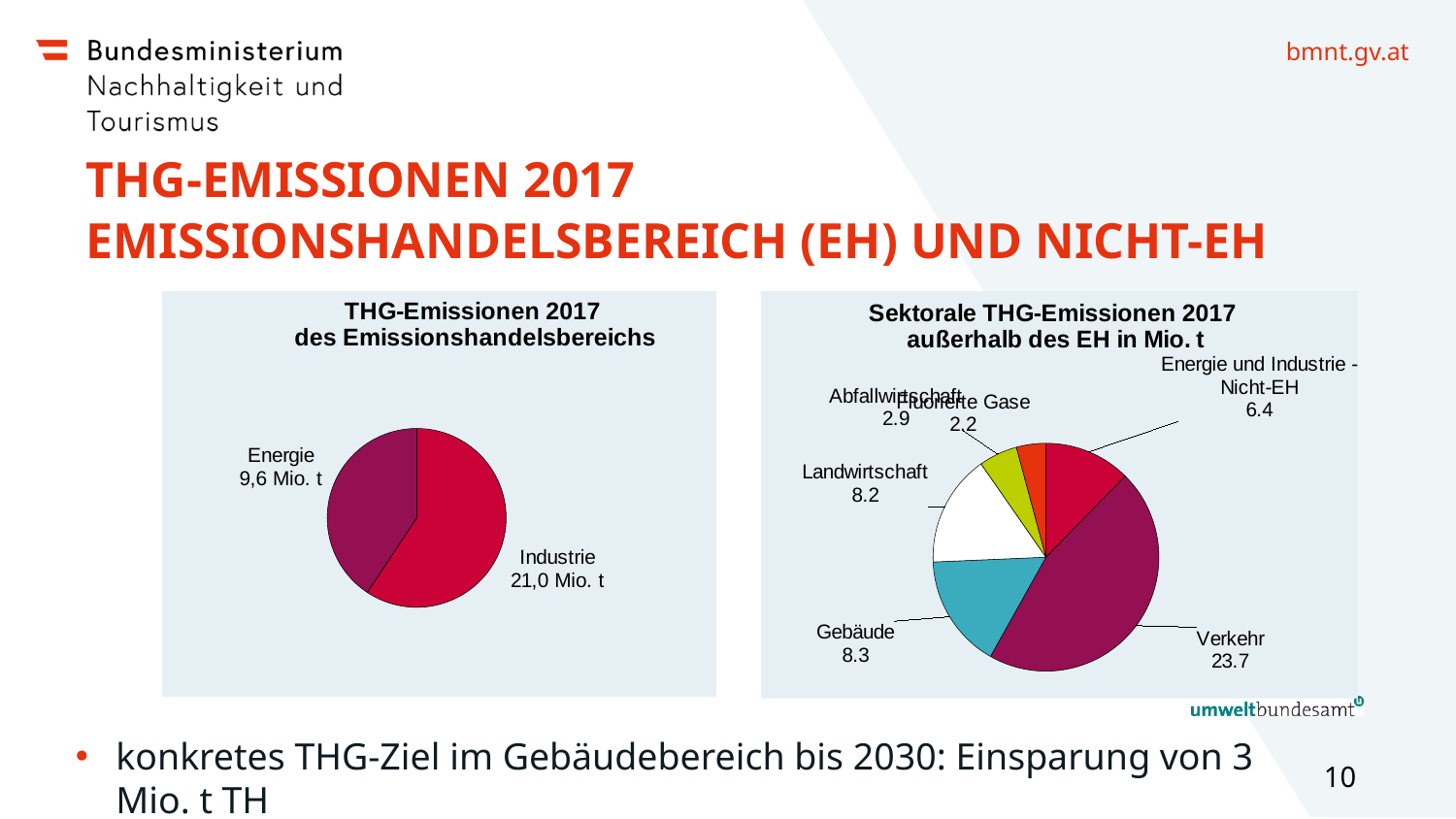
In the right chart 'Sektorale THG-Emissionen 2017 außerhalb des EH in Mio. t', which sector has the highest value? Verkehr In the left chart 'THG-Emissionen 2017 des Emissionshandelsbereichs', how many slices does the pie have? 2 In the right chart 'Sektorale THG-Emissionen 2017 außerhalb des EH in Mio. t', which is larger, Verkehr or Gebäude? Verkehr In the right chart 'Sektorale THG-Emissionen 2017 außerhalb des EH in Mio. t', which sector has the lowest value? Fluorierte Gase In the right chart 'Sektorale THG-Emissionen 2017 außerhalb des EH in Mio. t', what is the value for Energie und Industrie - Nicht-EH? 6.4 What type of chart is the left chart, 'THG-Emissionen 2017 des Emissionshandelsbereichs'? Pie chart In the right chart 'Sektorale THG-Emissionen 2017 außerhalb des EH in Mio. t', what is the value for Verkehr? 23.7 In the left chart 'THG-Emissionen 2017 des Emissionshandelsbereichs', what is the value for Energie? 9,6 Mio. t In the left chart 'THG-Emissionen 2017 des Emissionshandelsbereichs', what is the value for Industrie? 21,0 Mio. t In the left chart 'THG-Emissionen 2017 des Emissionshandelsbereichs', what is the total of the two slices? 30,6 Mio. t In the left chart 'THG-Emissionen 2017 des Emissionshandelsbereichs', what is the difference between Industrie and Energie? 11,4 Mio. t In the right chart 'Sektorale THG-Emissionen 2017 außerhalb des EH in Mio. t', how many sectors are shown? 6